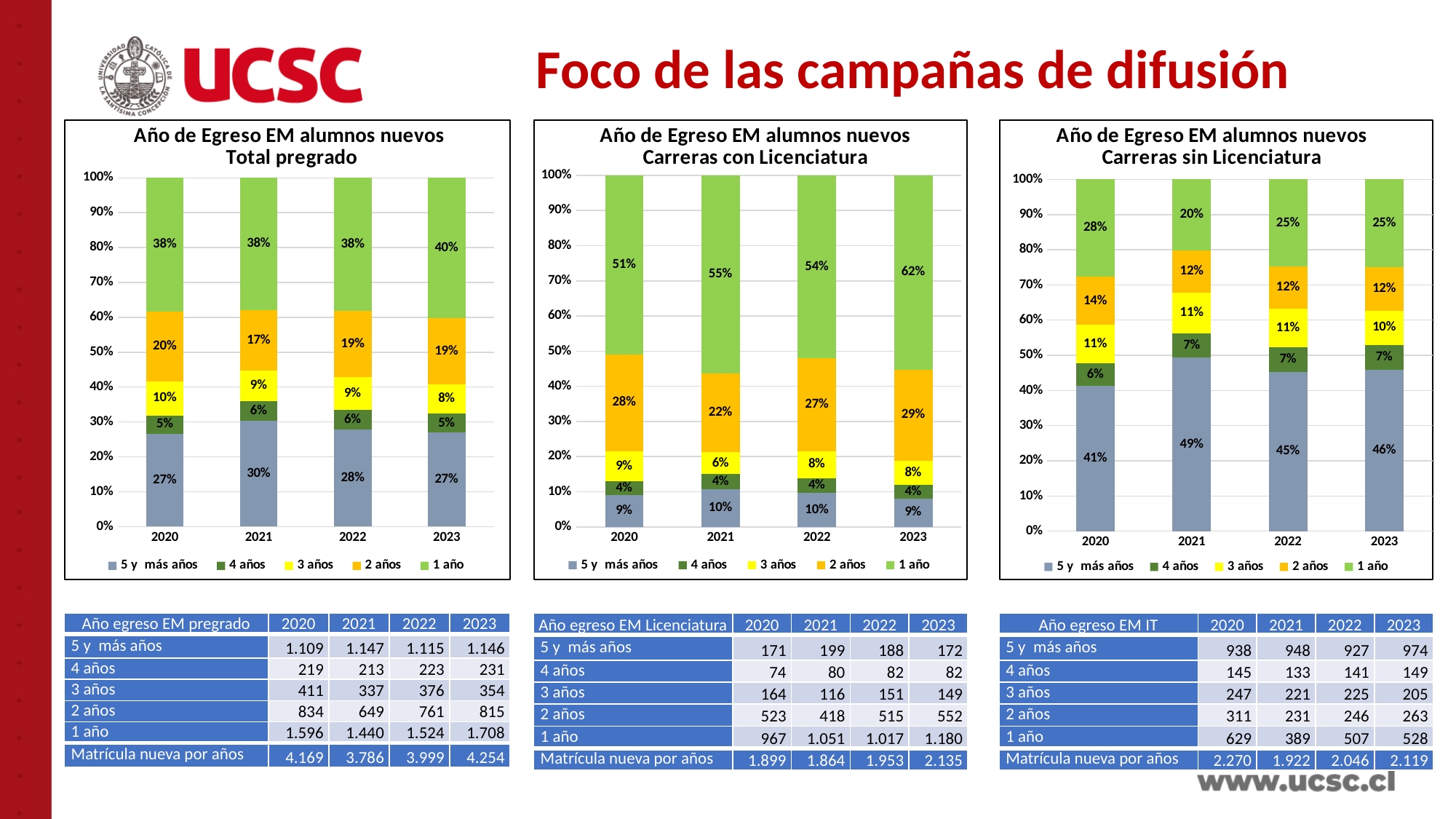
In the 'Carreras sin Licenciatura' chart, what is the difference between the '5 y más años' values for 2020 and 2021? 8% In the 'Total pregrado' chart, what is the value for '1 año' in 2023? 40% How many series does the legend of the 'Carreras con Licenciatura' chart list? 5 In the 'Carreras con Licenciatura' chart, what is the value for '2 años' in 2023? 29% In the 'Total pregrado' chart, what is the difference between the '2 años' values for 2020 and 2021? 3% In the 'Carreras sin Licenciatura' chart, which year has the lowest value for '1 año'? 2021 In the 'Carreras con Licenciatura' chart, which year has the highest value for '1 año'? 2023 How many years are shown on the x axis of the 'Total pregrado' chart? 4 In the 'Carreras con Licenciatura' chart, which is larger: the '1 año' value in 2021 or in 2022? 2021 In the 'Carreras con Licenciatura' chart, does the '1 año' value rise or fall from 2022 to 2023? Rise What kind of chart is the 'Carreras sin Licenciatura' chart? Stacked bar chart In the 'Carreras sin Licenciatura' chart, what is the value for '5 y más años' in 2021? 49%